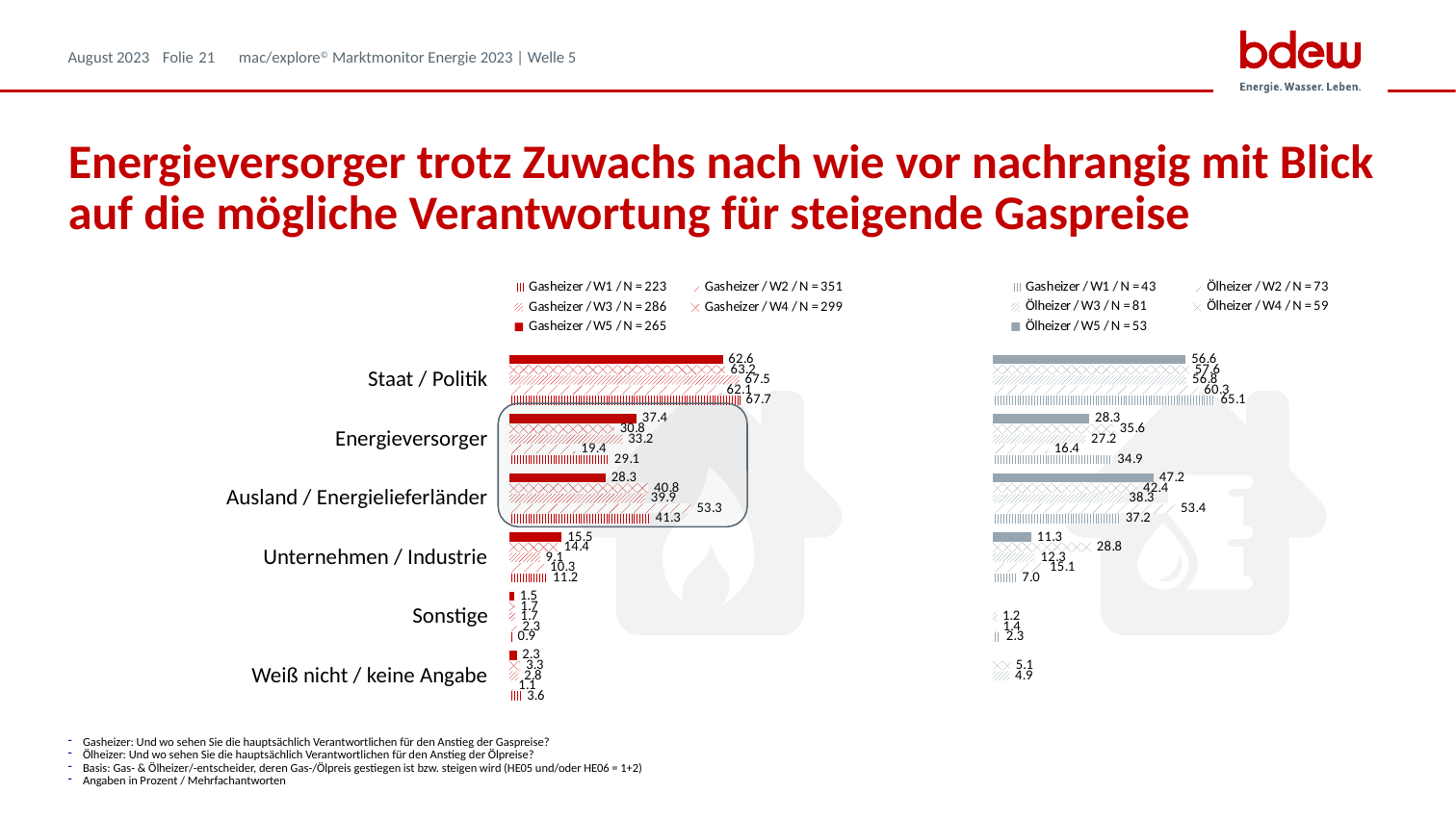
In the left chart (Gasheizer), which category has the lowest value in the Gasheizer / W5 series? Sonstige What kind of chart is the right chart (Ölheizer)? Bar chart In the left chart (Gasheizer), what is the difference between the Gasheizer / W5 values for Staat / Politik and Energieversorger? 25.2 In the left chart (Gasheizer), what is the value for Energieversorger in the Gasheizer / W5 series? 37.4 In the left chart (Gasheizer), which category has the highest value in the Gasheizer / W5 series? Staat / Politik In the left chart (Gasheizer), what is the value for Staat / Politik in the Gasheizer / W5 series? 62.6 In the right chart (Ölheizer), which is larger in the Ölheizer / W5 series: Energieversorger or Ausland / Energielieferländer? Ausland / Energielieferländer How many series does the legend of the left chart (Gasheizer) list? 5 According to the legend of the left chart, what is the N for Gasheizer / W5? 265 How many categories are shown on the left chart (Gasheizer)? 6 In the right chart (Ölheizer), what is the value for Ausland / Energielieferländer in the Ölheizer / W5 series? 47.2